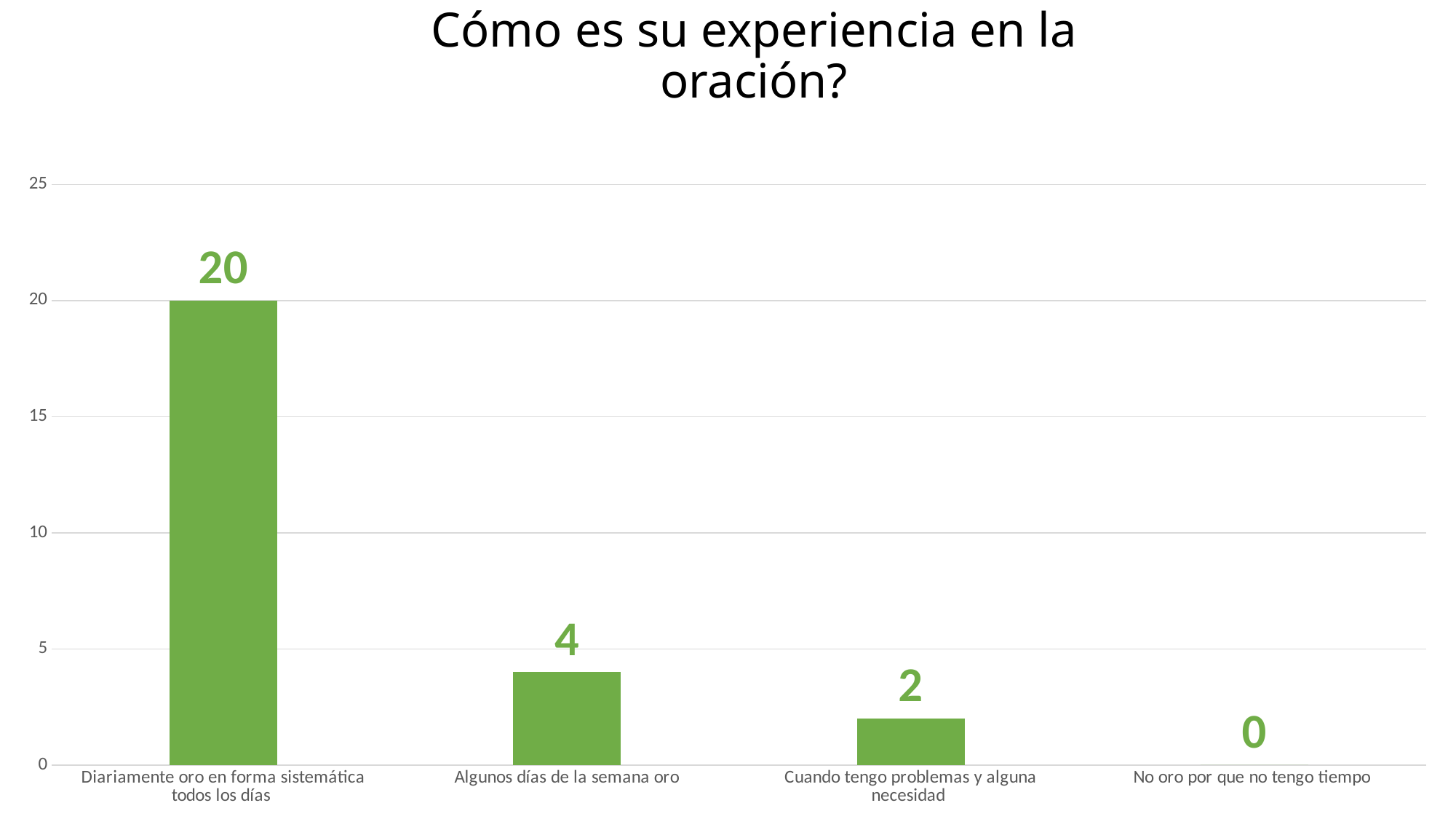
What is the difference between the values for "Diariamente oro en forma sistemática todos los días" and "Algunos días de la semana oro"? 16 Is the value for "Diariamente oro en forma sistemática todos los días" greater or less than 15? greater What kind of chart is shown on the slide? bar chart What is the value for "Diariamente oro en forma sistemática todos los días"? 20 What is the value for "Algunos días de la semana oro"? 4 What is the value for "No oro por que no tengo tiempo"? 0 How many categories are shown on the chart? 4 Which category has the highest value? Diariamente oro en forma sistemática todos los días What is the title of the chart? Cómo es su experiencia en la oración? What is the value for "Cuando tengo problemas y alguna necesidad"? 2 Which category has the lowest value? No oro por que no tengo tiempo Which is larger, the value for "Algunos días de la semana oro" or for "Cuando tengo problemas y alguna necesidad"? Algunos días de la semana oro